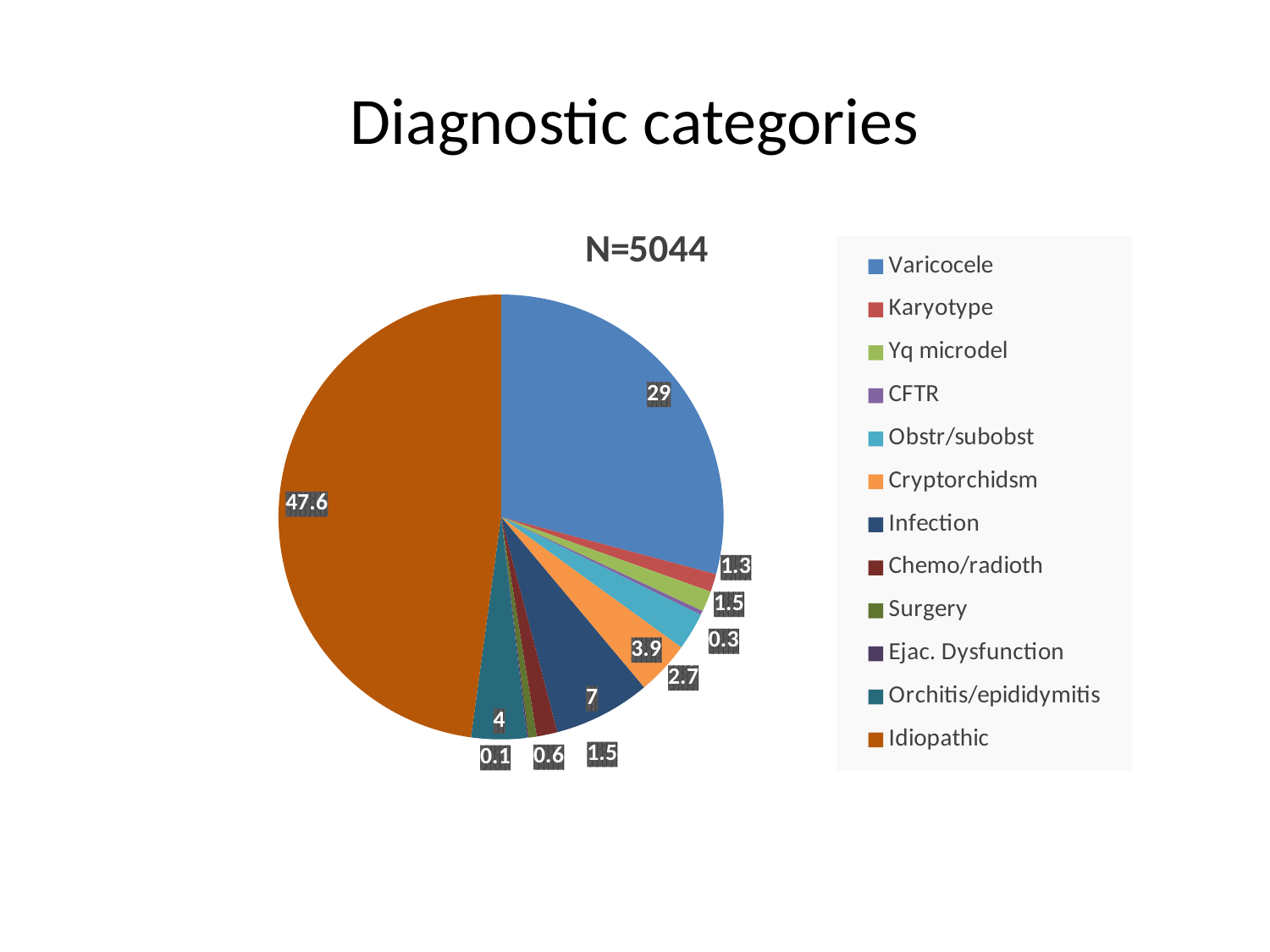
What is the chart title shown above the pie? N=5044 What is the value shown for Orchitis/epididymitis? 4 Which category has the largest slice? Idiopathic What is the value shown for Varicocele? 29 What is the value shown for Idiopathic? 47.6 What type of chart is shown on the slide? Pie chart What is the value shown for Infection? 7 How many categories does the legend list? 12 What is the difference between the values for Idiopathic and Varicocele? 18.6 Which category has the smallest slice? Ejac. Dysfunction What is the value shown for Cryptorchidsm? 3.9 Which is larger, the value for Infection or the value for Cryptorchidsm? Infection